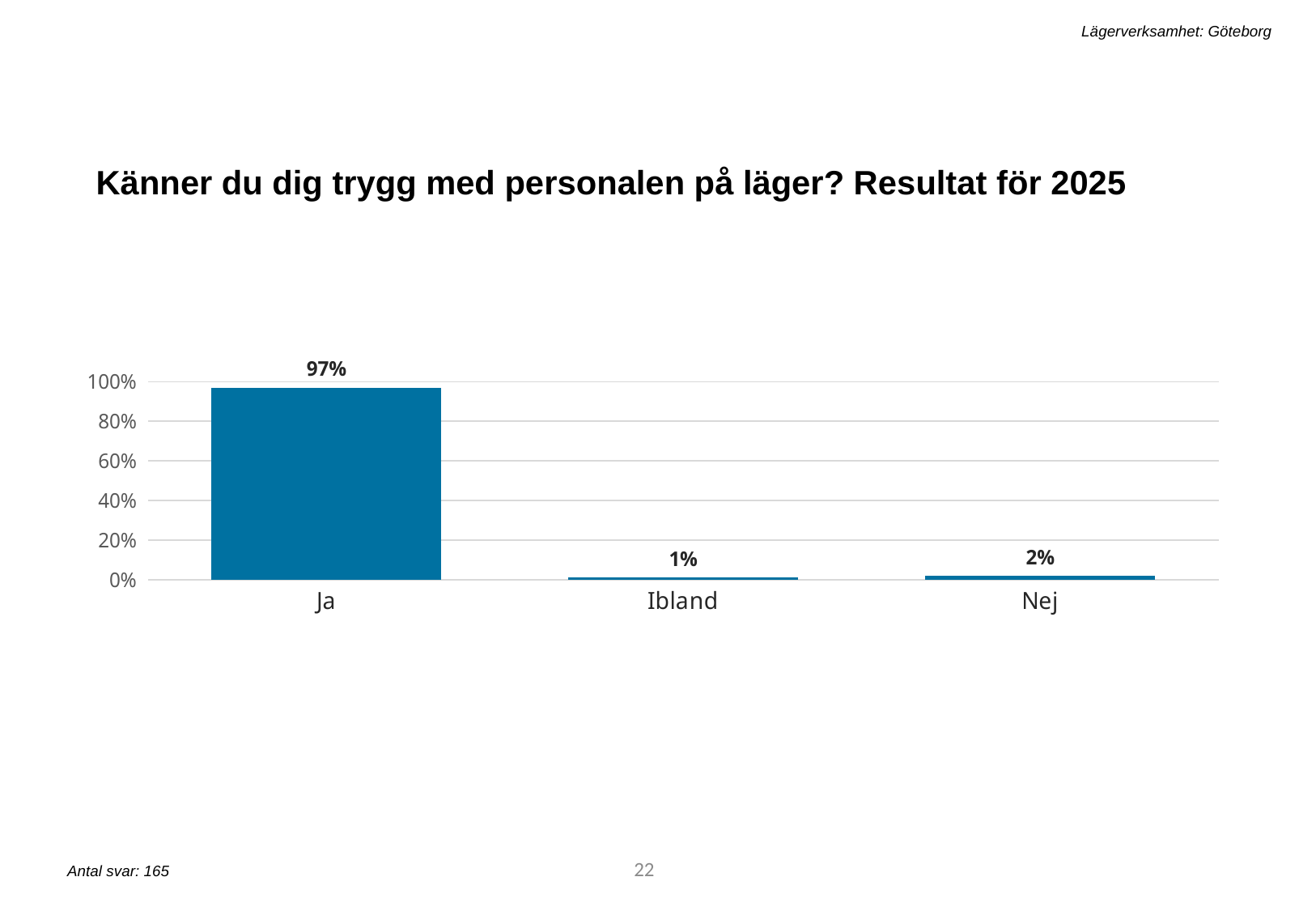
How many categories are shown on the x axis? 3 What kind of chart is shown on the slide? bar chart What is the difference between the values for Nej and Ibland? 1% What is the difference between the values for Ja and Nej? 95% Which category has the lowest value? Ibland What is the title of the chart? Känner du dig trygg med personalen på läger? Resultat för 2025 What is the value for Nej? 2% Which is larger, the value for Nej or the value for Ibland? Nej Which category has the highest value? Ja Is the value for Ja greater or less than 80%? greater What is the value for Ja? 97% What is the value for Ibland? 1%